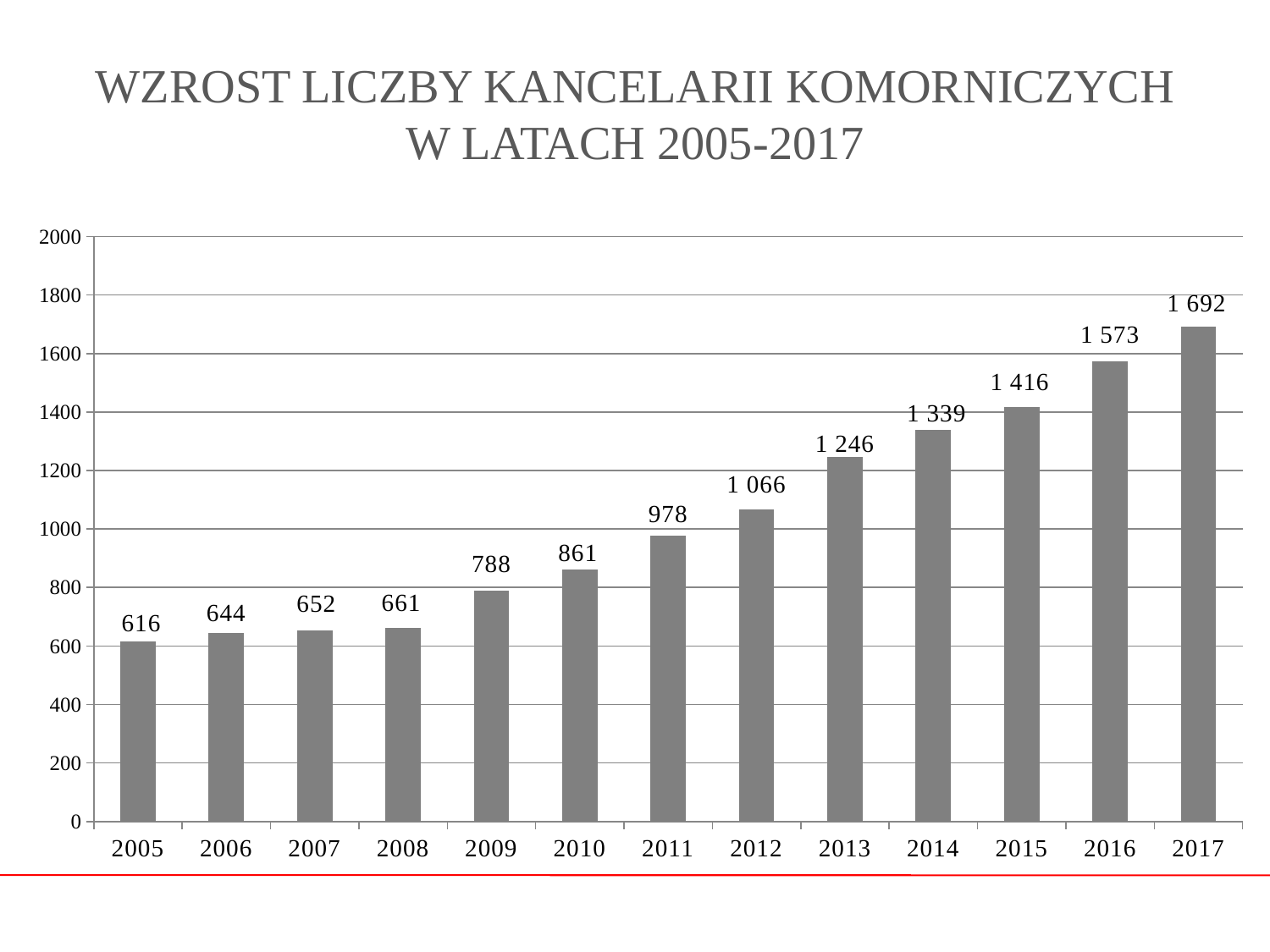
Do the values rise or fall from 2005 to 2017? rise What is the value for 2005? 616 Which year has the highest value? 2017 Which is larger, the value for 2013 or the value for 2011? 2013 Which year has the lowest value? 2005 What is the value for 2017? 1 692 Is the value for 2015 greater or less than 1400? greater What is the value for 2012? 1 066 How many years are shown on the x axis? 13 What is the difference between the values for 2017 and 2016? 119 What kind of chart is shown on the slide? bar chart What is the difference between the values for 2010 and 2009? 73